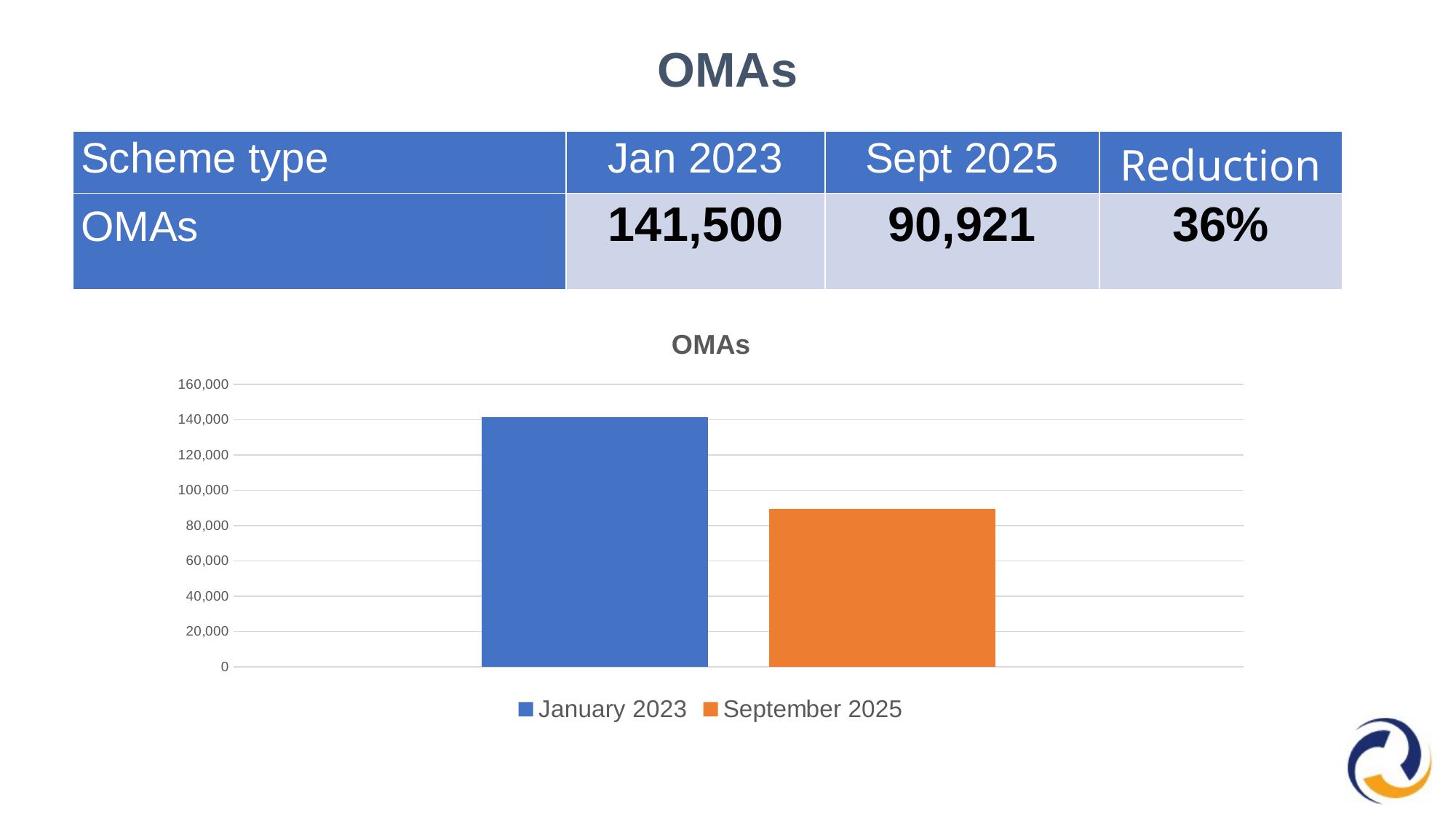
Do the values rise or fall from January 2023 to September 2025? fall Which series has the taller bar, January 2023 or September 2025? January 2023 Which series has the highest value in the chart? January 2023 Is the value for September 2025 greater or less than 80,000? greater How many bars are plotted in the chart? 2 Is the value for September 2025 greater or less than 100,000? less What kind of chart is shown on the slide? bar chart How many series does the chart legend list? 2 What colour is the September 2025 bar? orange What is the title of the chart? OMAs Which series has the lowest value in the chart? September 2025 Is the value for January 2023 greater or less than 140,000? greater